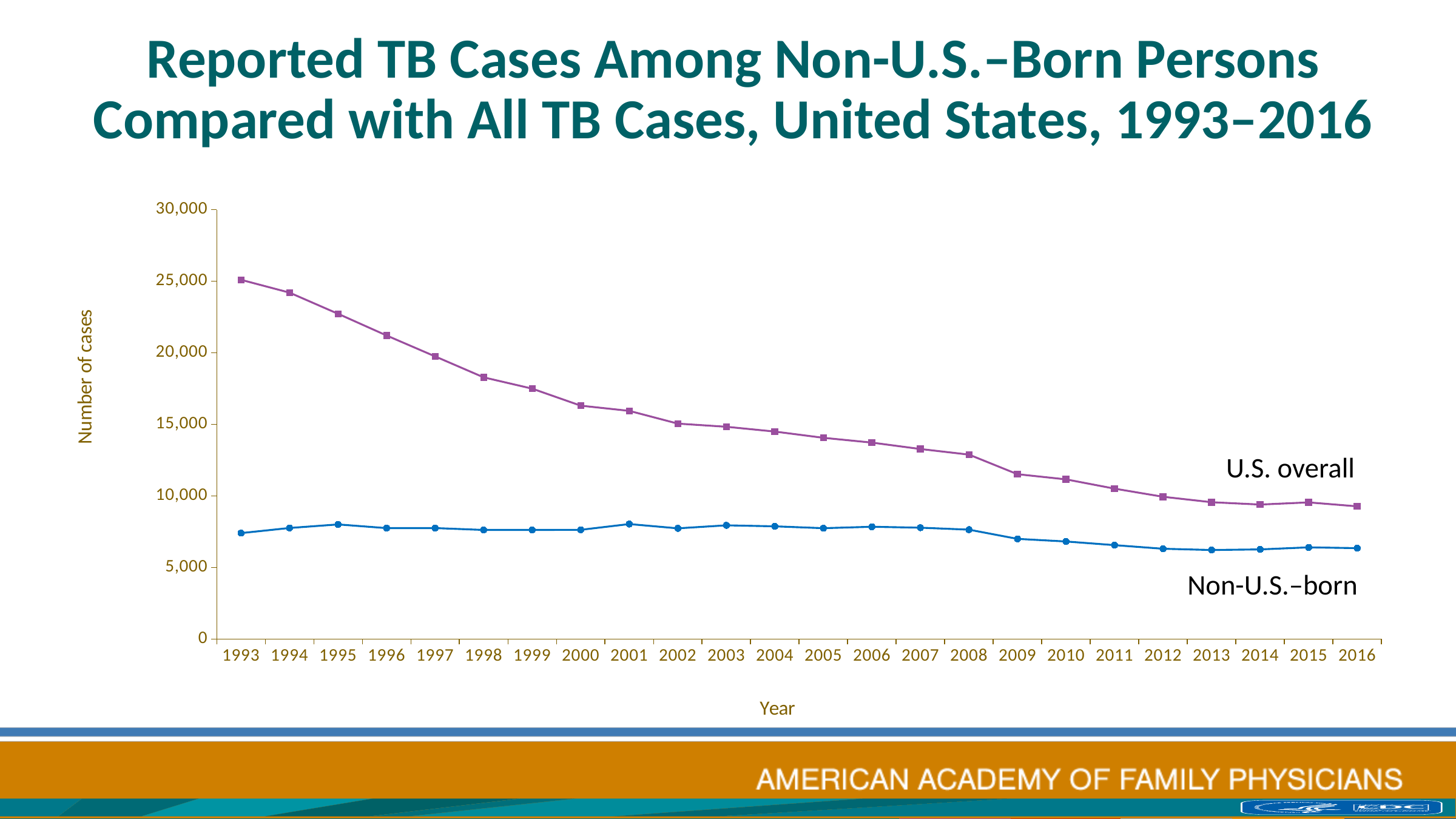
Is the U.S. overall value for 2000 greater or less than 15,000? greater Does the U.S. overall series rise or fall from 1993 to 2016? fall In 2016, which series has the higher value, U.S. overall or Non-U.S.-born? U.S. overall How many years are plotted along the x axis? 24 In which year is the U.S. overall series at its highest? 1993 Is the Non-U.S.-born value for 1995 greater or less than 10,000? less Is the Non-U.S.-born value for 2001 greater or less than 5,000? greater What type of chart is shown on the slide? line chart How many data series are plotted on the chart? 2